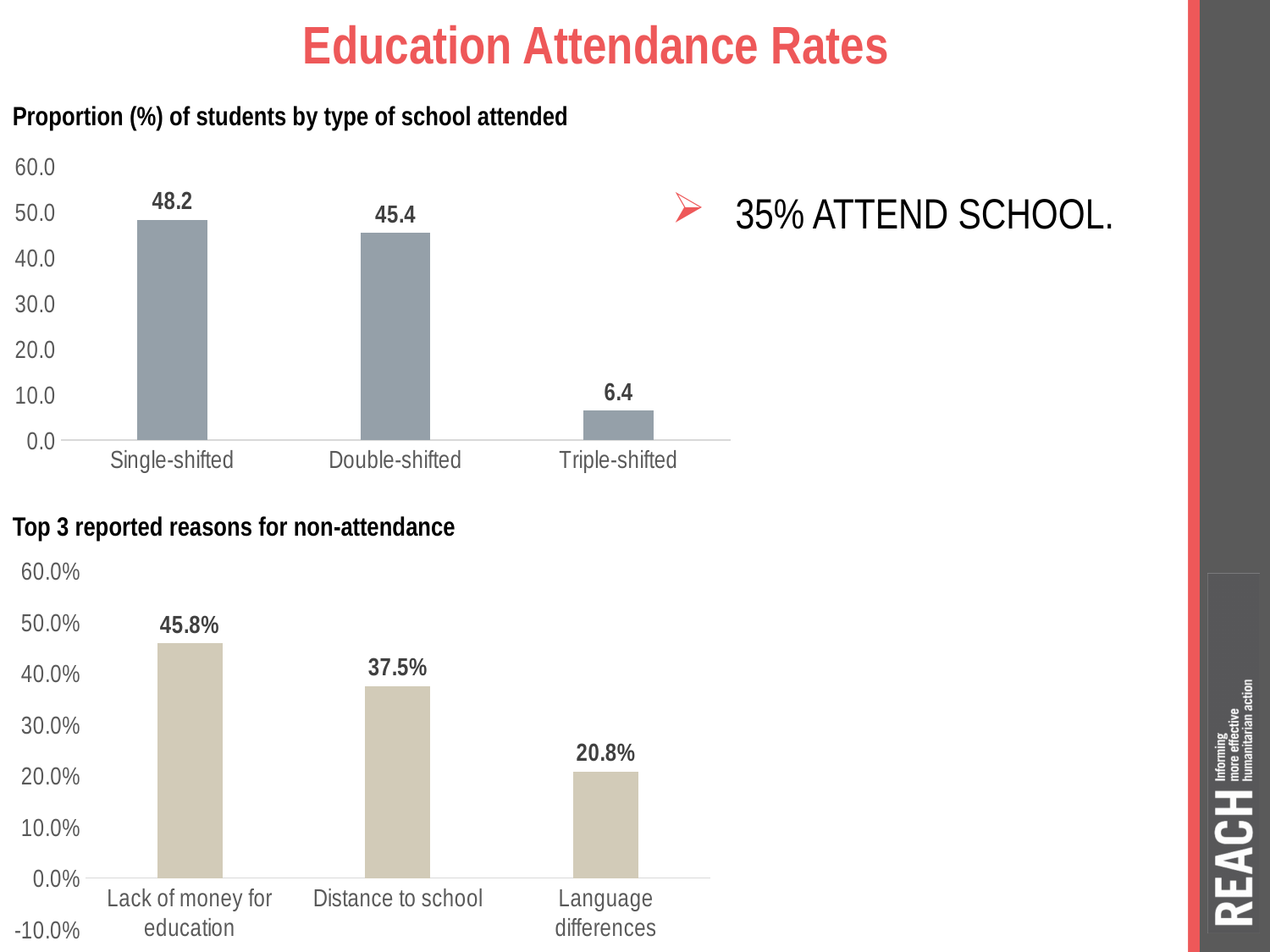
In the 'Top 3 reported reasons for non-attendance' chart, which is larger: Distance to school or Language differences? Distance to school In the 'Proportion (%) of students by type of school attended' chart, what is the value for Single-shifted? 48.2 In the 'Proportion (%) of students by type of school attended' chart, what is the difference between Single-shifted and Double-shifted? 2.8 In the 'Proportion (%) of students by type of school attended' chart, what is the value for Triple-shifted? 6.4 In the 'Proportion (%) of students by type of school attended' chart, which category has the lowest value? Triple-shifted What type of chart is the 'Top 3 reported reasons for non-attendance' chart? bar chart In the 'Top 3 reported reasons for non-attendance' chart, which reason has the highest value? Lack of money for education In the 'Proportion (%) of students by type of school attended' chart, do the values rise or fall from left to right? fall In the 'Proportion (%) of students by type of school attended' chart, how many categories are shown? 3 In the 'Top 3 reported reasons for non-attendance' chart, what is the value for Distance to school? 37.5% In the 'Top 3 reported reasons for non-attendance' chart, what is the value for Language differences? 20.8% In the 'Top 3 reported reasons for non-attendance' chart, what is the difference between Lack of money for education and Language differences? 25.0%